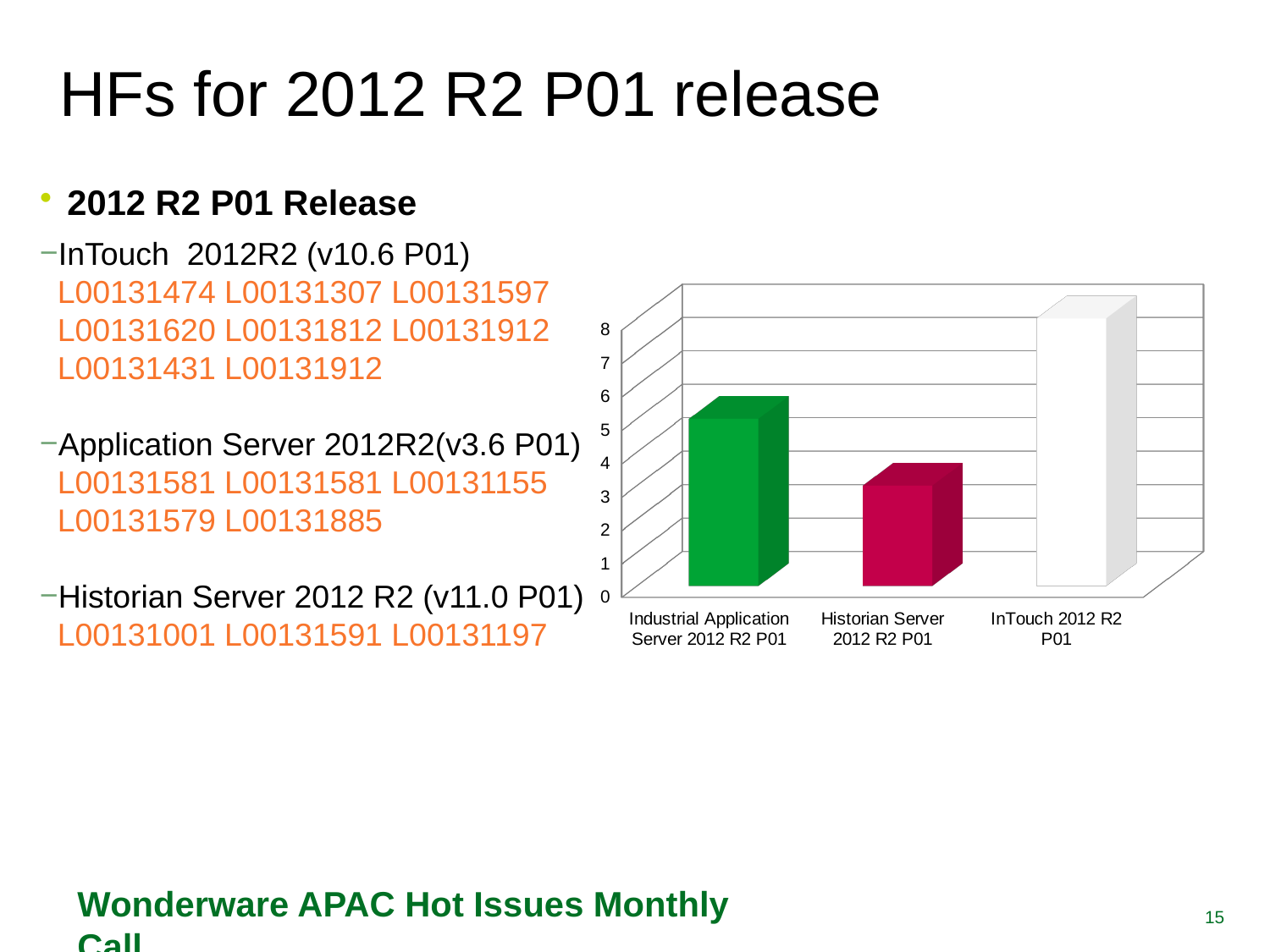
What colour is the bar for Historian Server 2012 R2 P01? red Is the value for Industrial Application Server 2012 R2 P01 greater or less than 6? less What kind of chart is shown on the slide? bar chart Which category has the highest bar in the chart? InTouch 2012 R2 P01 Which category has the lowest bar in the chart? Historian Server 2012 R2 P01 Which is larger, the value for Industrial Application Server 2012 R2 P01 or the value for Historian Server 2012 R2 P01? Industrial Application Server 2012 R2 P01 Which is larger, the value for InTouch 2012 R2 P01 or the value for Industrial Application Server 2012 R2 P01? InTouch 2012 R2 P01 How many categories are plotted in the chart? 3 Is the value for Industrial Application Server 2012 R2 P01 greater or less than 4? greater Is the value for Historian Server 2012 R2 P01 greater or less than 4? less What is the highest value shown on the vertical axis of the chart? 8